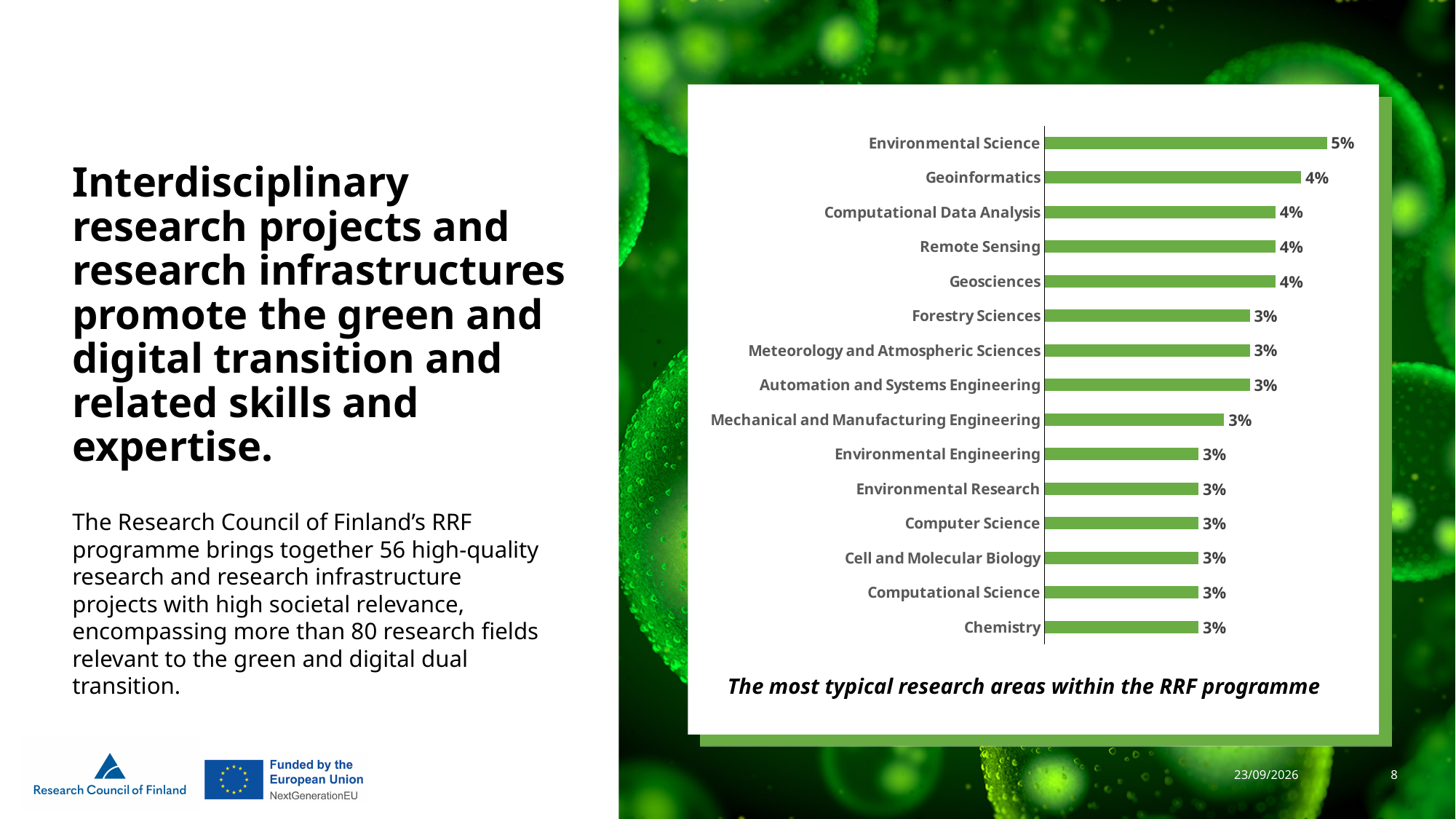
Which research area has the highest value? Environmental Science How many research areas are shown in the chart? 15 Which is larger, the value for Environmental Science or the value for Geoinformatics? Environmental Science What is the value for Remote Sensing? 4% What is the value for Chemistry? 3% What kind of chart is shown on the slide? Bar chart What is the title of the chart? The most typical research areas within the RRF programme What is the value for Environmental Science? 5% What is the difference between the values for Geosciences and Computer Science? 1 percentage point What is the value for Geoinformatics? 4% What is the difference between the values for Environmental Science and Chemistry? 2 percentage points What is the value for Forestry Sciences? 3%